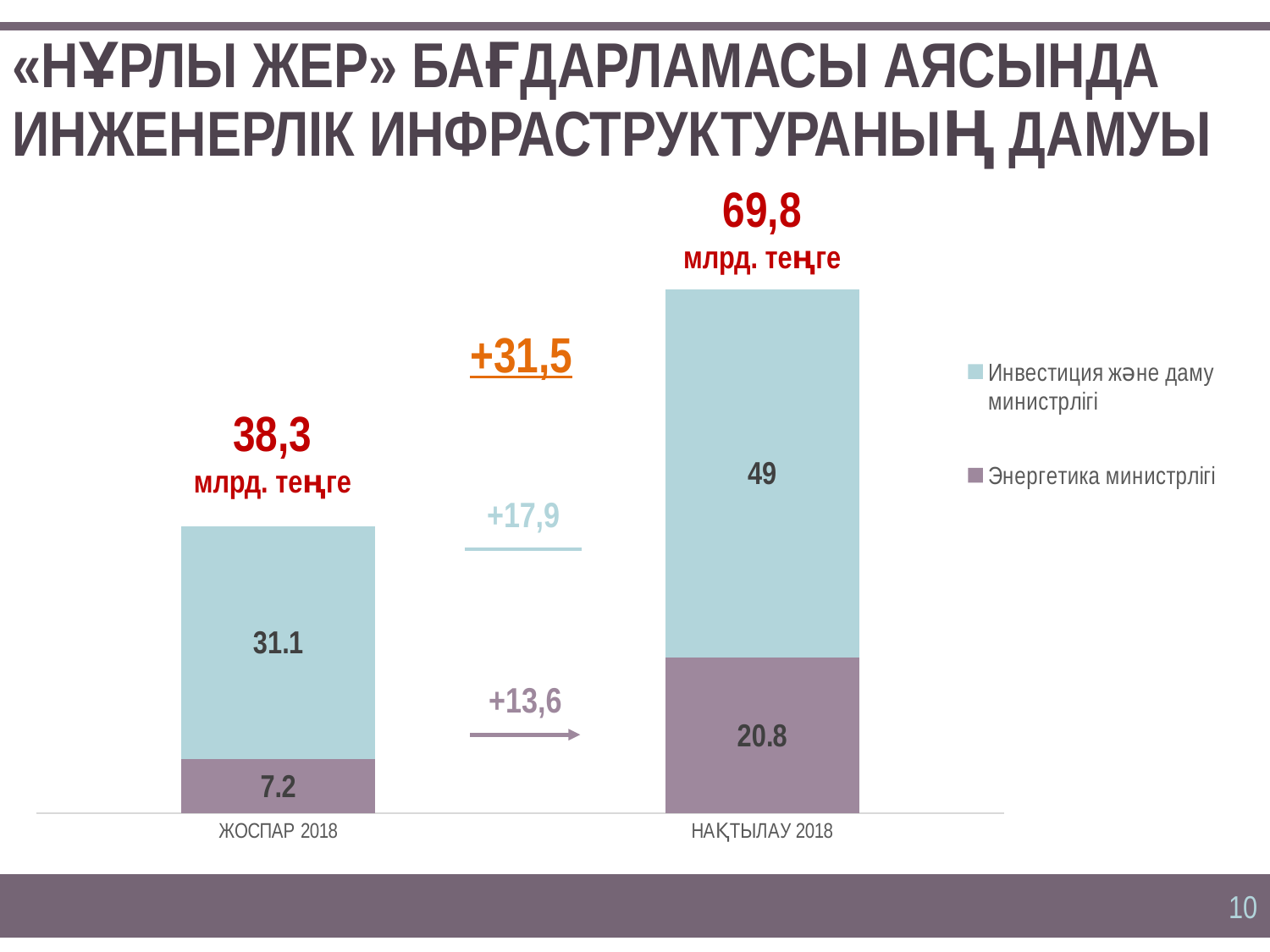
How many series does the legend list? 2 What is the value for Энергетика министрлігі in НАҚТЫЛАУ 2018? 20.8 What is the difference between the Инвестиция және даму министрлігі values for НАҚТЫЛАУ 2018 and ЖОСПАР 2018? 17.9 What type of chart is shown on the slide? stacked bar chart What is the total shown for the ЖОСПАР 2018 bar? 38,3 млрд. теңге What is the value for Энергетика министрлігі in ЖОСПАР 2018? 7.2 How many categories are shown on the x axis? 2 Which category has the higher value for Энергетика министрлігі? НАҚТЫЛАУ 2018 What is the total shown for the НАҚТЫЛАУ 2018 bar? 69,8 млрд. теңге Which legend entry is shown in purple? Энергетика министрлігі What is the value for Инвестиция және даму министрлігі in ЖОСПАР 2018? 31.1 What is the value for Инвестиция және даму министрлігі in НАҚТЫЛАУ 2018? 49